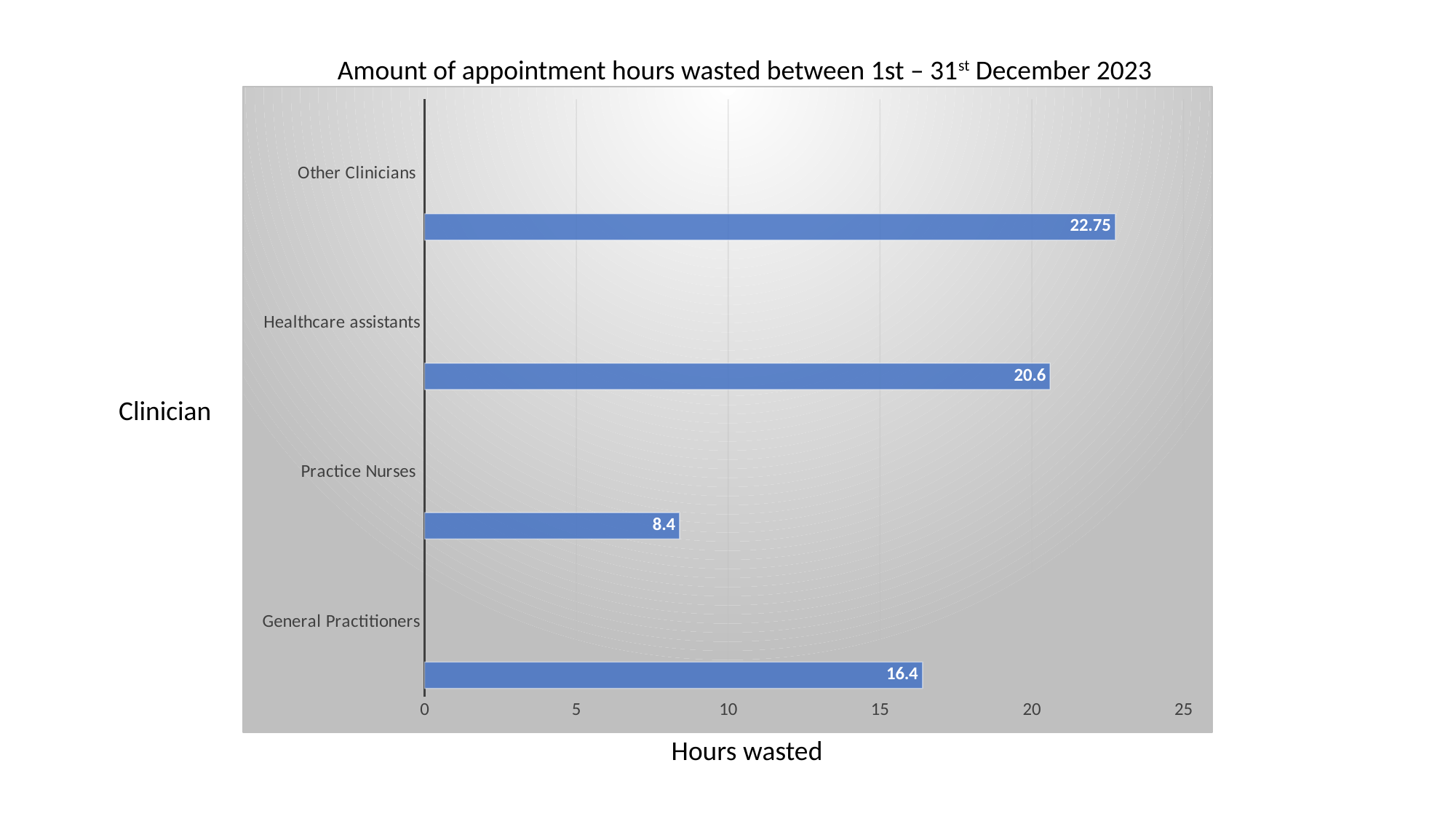
Which clinician category has the highest number of hours wasted? Other Clinicians What is the title of the chart? Amount of appointment hours wasted between 1st – 31st December 2023 Which has more hours wasted, Healthcare assistants or General Practitioners? Healthcare assistants How many hours were wasted for General Practitioners? 16.4 Which clinician category has the lowest number of hours wasted? Practice Nurses What is the difference in hours wasted between Other Clinicians and General Practitioners? 6.35 What type of chart is shown on the slide? Bar chart How many hours were wasted for Healthcare assistants? 20.6 How many clinician categories are shown in the chart? 4 How many hours were wasted for Practice Nurses? 8.4 What is the label of the horizontal axis? Hours wasted How many hours were wasted for Other Clinicians? 22.75